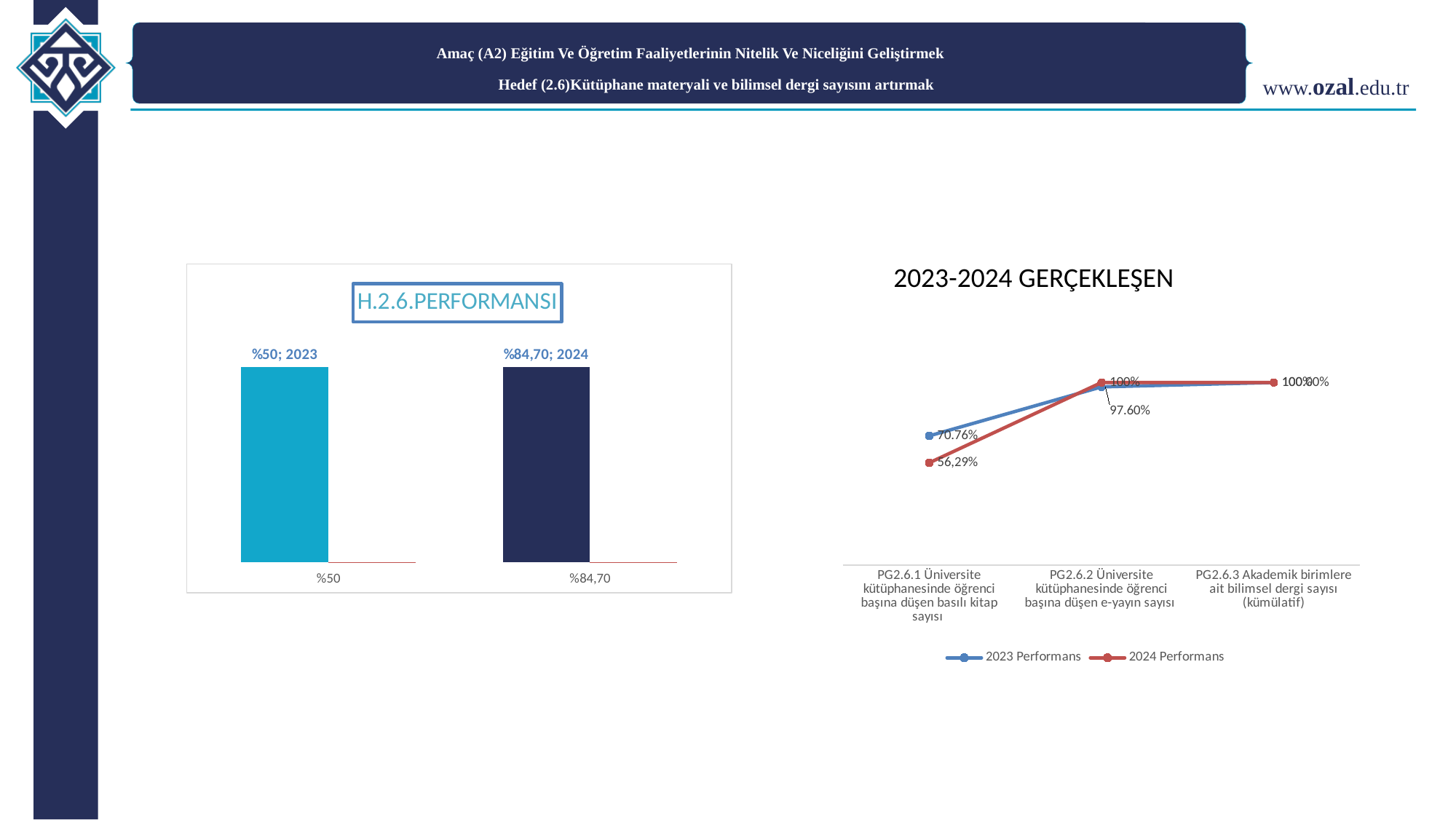
In the 2023-2024 GERÇEKLEŞEN chart, which series has the higher value for PG2.6.1, 2023 Performans or 2024 Performans? 2023 Performans In the 2023-2024 GERÇEKLEŞEN chart, what is the 2023 Performans value for PG2.6.1? 70.76% In the 2023-2024 GERÇEKLEŞEN chart, what is the 2023 Performans value for PG2.6.2? 97.60% In the 2023-2024 GERÇEKLEŞEN chart, what is the 2024 Performans value for PG2.6.1? 56,29% In the H.2.6.PERFORMANSI bar chart, what is the value for 2023? %50 What kind of chart is the 2023-2024 GERÇEKLEŞEN chart on the right? line chart How many bars are shown in the H.2.6.PERFORMANSI chart? 2 In the 2023-2024 GERÇEKLEŞEN chart, how many categories are shown on the x axis? 3 What kind of chart is the H.2.6.PERFORMANSI chart on the left? bar chart How many series does the legend of the 2023-2024 GERÇEKLEŞEN chart list? 2 In the H.2.6.PERFORMANSI bar chart, what is the value for 2024? %84,70 In the 2023-2024 GERÇEKLEŞEN chart, what is the 2024 Performans value for PG2.6.2? 100%